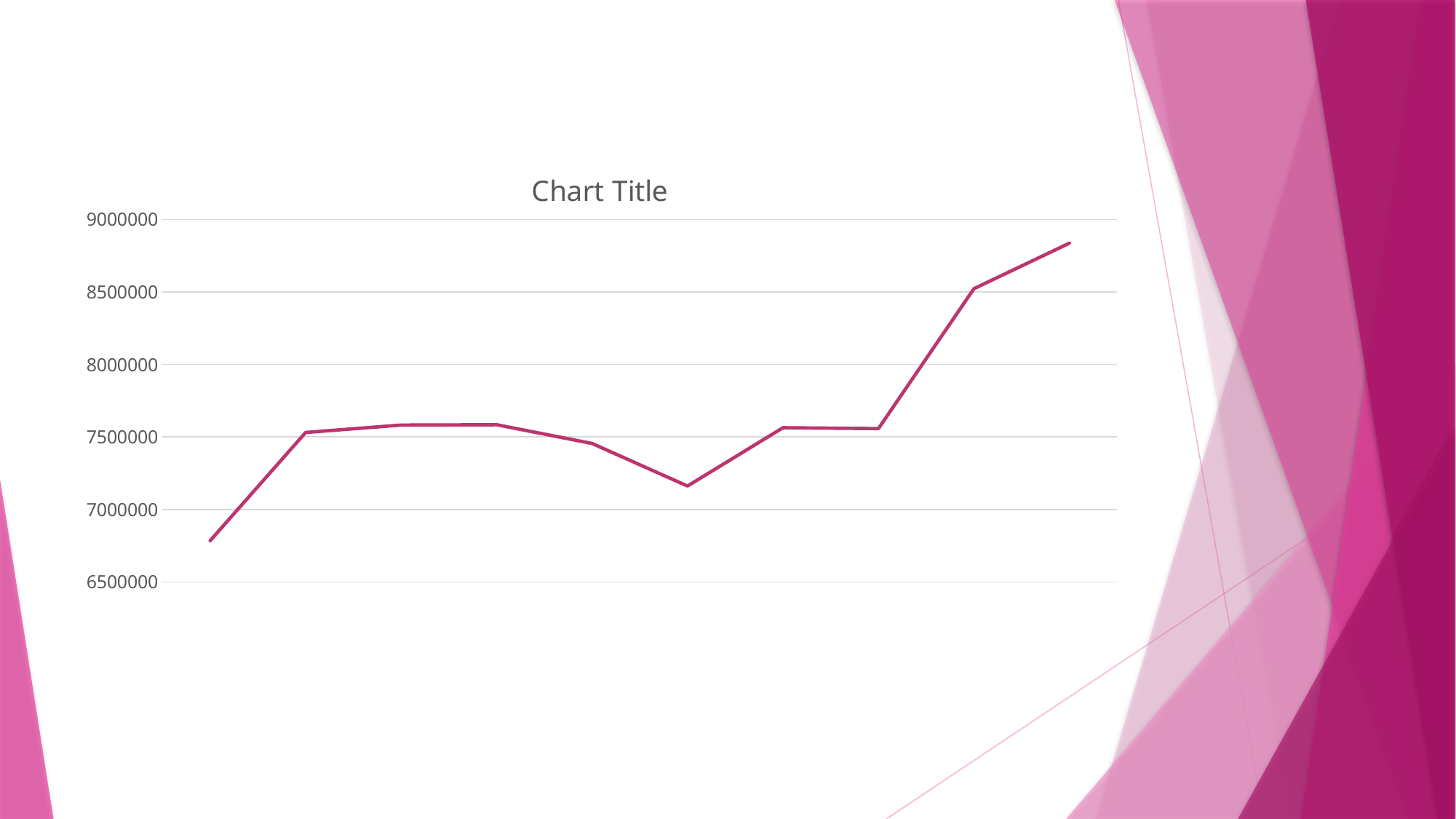
Is the value of the last point on the line greater or less than 8500000? greater What kind of chart is shown on the slide? line chart Is the value of the first point on the line greater or less than 7000000? less How many data points are plotted on the line? 10 What is the highest value shown on the vertical axis? 9000000 Which is larger, the value of the second point or the value of the sixth point? the second point Is the value of the second point on the line greater or less than 7500000? greater What is the title of the chart? Chart Title Which point on the line is the lowest, the first or the last? the first Which point on the line is the highest, the first or the last? the last Overall, does the line rise or fall from the first point to the last point? rise